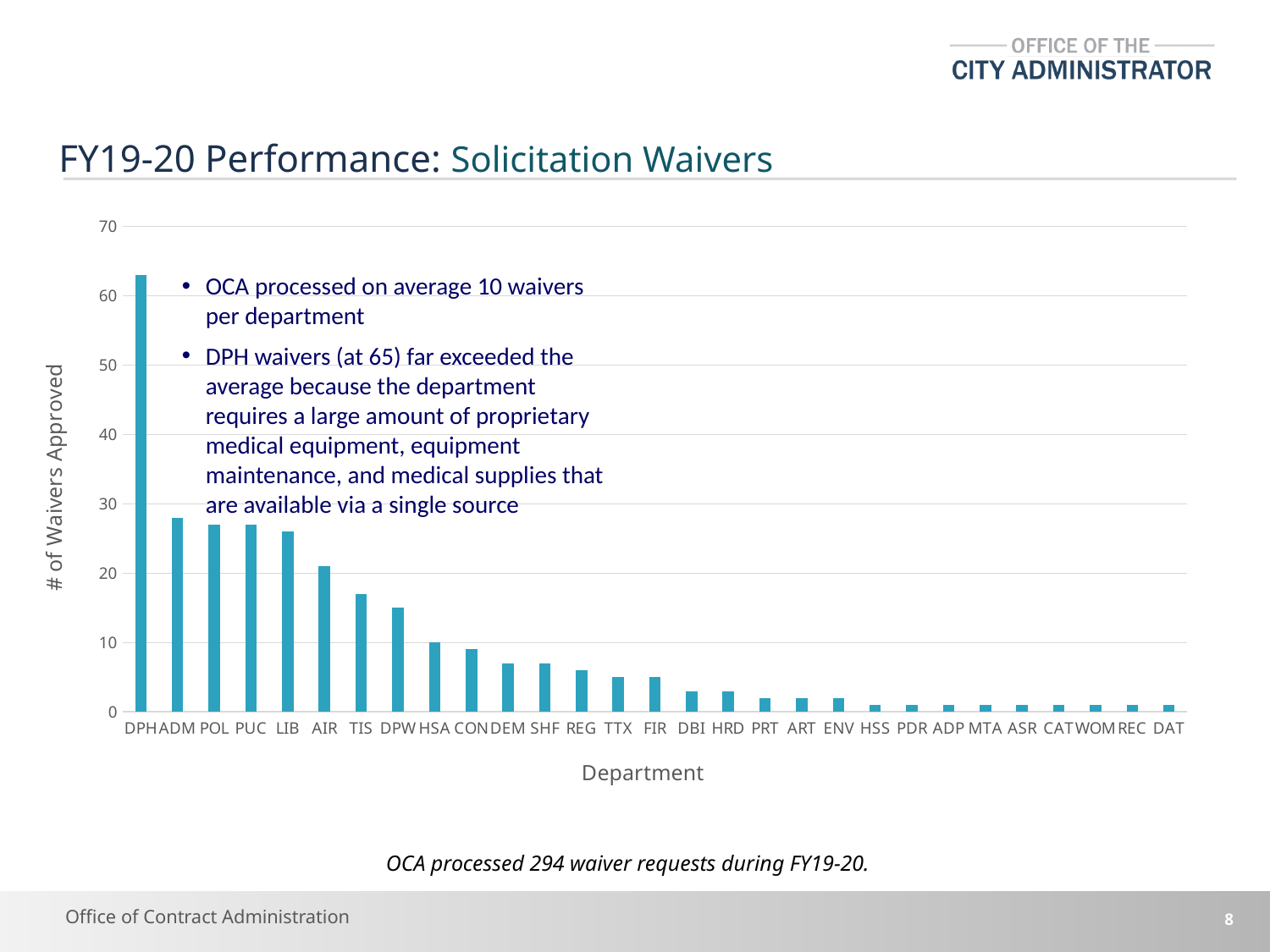
According to the slide, how many waivers did DPH have? 65 Is the value for DBI greater or less than 10? less What is the label of the vertical axis of the chart? # of Waivers Approved Is the value for ADM greater or less than 20? greater Is the value for TIS greater or less than 20? less Which department has the highest number of waivers approved? DPH Do the bar values rise or fall moving from left to right along the x axis? fall What kind of chart is shown on the slide? bar chart Which department has more waivers approved, ADM or TIS? ADM How many departments are shown on the x axis of the chart? 29